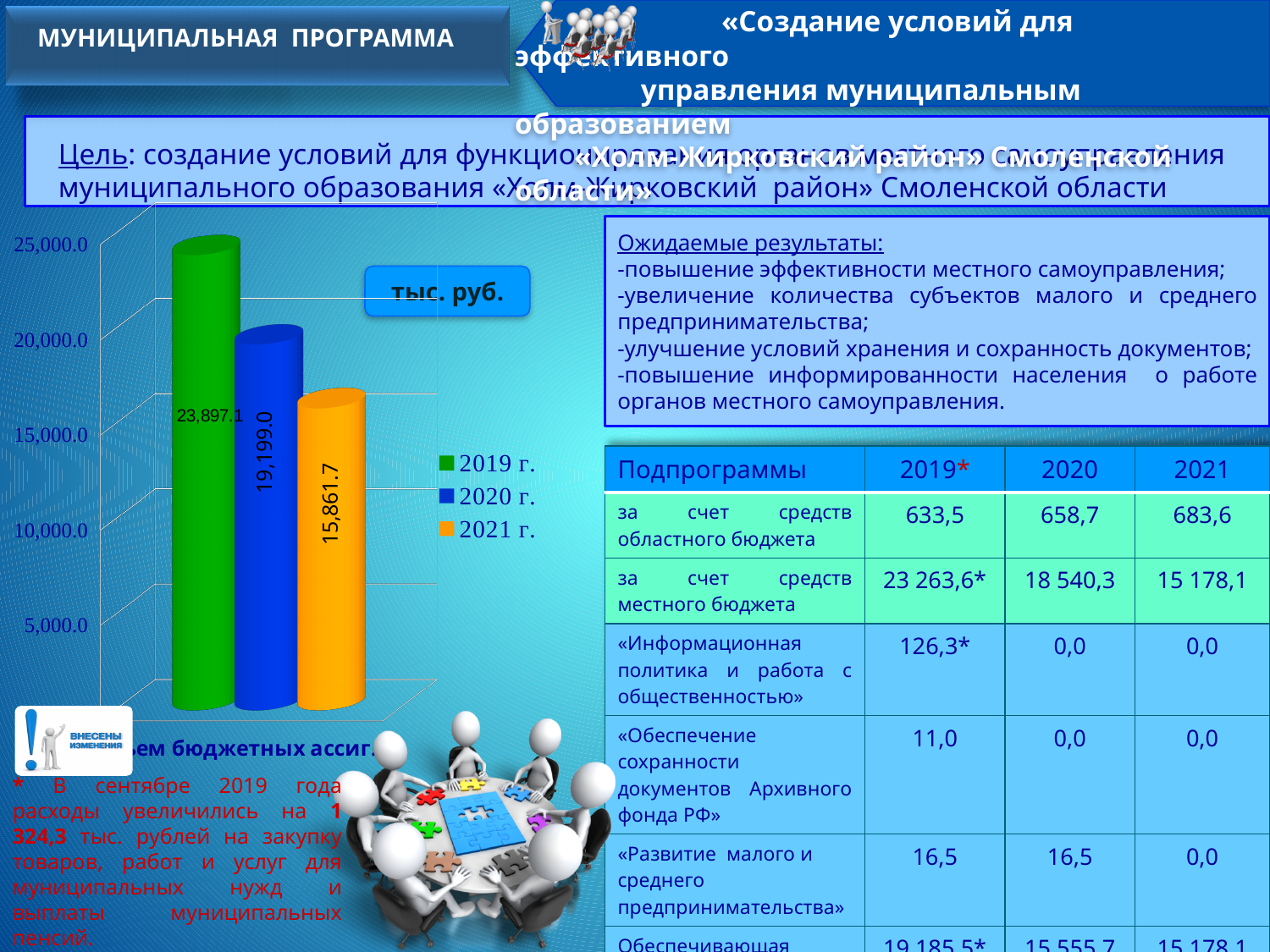
How many series does the legend of the bar chart list? 3 What is the value for 2021 г. in the bar chart? 15,861.7 Which is larger in the bar chart, the value for 2020 г. or 2021 г.? 2020 г. Which year has the lowest value in the bar chart? 2021 г. What is the difference between the 2019 г. and 2020 г. values in the bar chart? 4,698.1 Is the value for 2020 г. in the bar chart greater or less than 20,000.0? less What is the value for 2019 г. in the bar chart? 23,897.1 What kind of chart is shown on the left of the slide? bar chart What is the difference between the 2020 г. and 2021 г. values in the bar chart? 3,337.3 Which year has the highest value in the bar chart? 2019 г. Do the values in the bar chart rise or fall from 2019 г. to 2021 г.? fall What is the value for 2020 г. in the bar chart? 19,199.0